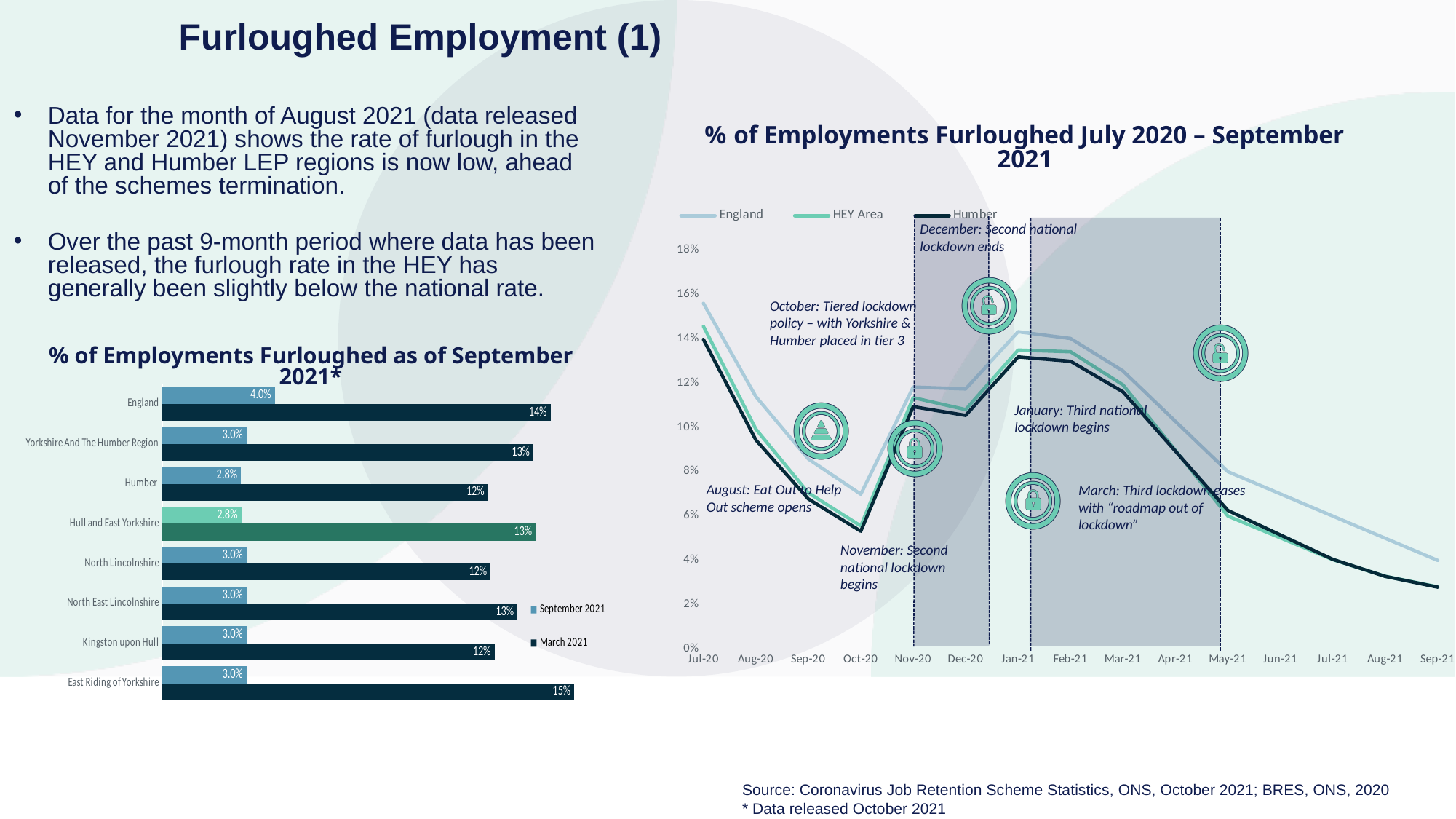
In the chart '% of Employments Furloughed as of September 2021*', which is larger: the March 2021 value for Humber or for Hull and East Yorkshire? Hull and East Yorkshire How many categories are shown in the chart '% of Employments Furloughed as of September 2021*'? 8 In the chart '% of Employments Furloughed as of September 2021*', what is the September 2021 value for Hull and East Yorkshire? 2.8% In the chart '% of Employments Furloughed as of September 2021*', which category has the highest March 2021 value? East Riding of Yorkshire In the chart '% of Employments Furloughed as of September 2021*', what is the March 2021 value for East Riding of Yorkshire? 15% In the chart '% of Employments Furloughed July 2020 – September 2021', how many series does the legend list? 3 In the chart '% of Employments Furloughed as of September 2021*', what is the difference between the March 2021 and September 2021 values for England? 10% In the chart '% of Employments Furloughed as of September 2021*', what is the September 2021 value for England? 4.0% What kind of chart is '% of Employments Furloughed July 2020 – September 2021'? Line chart In the chart '% of Employments Furloughed July 2020 – September 2021', do the values for Humber rise or fall from Feb-21 to Sep-21? Fall How many series does the legend list in the chart '% of Employments Furloughed as of September 2021*'? 2 In the chart '% of Employments Furloughed July 2020 – September 2021', is the England value at Jul-20 greater or less than 14%? greater